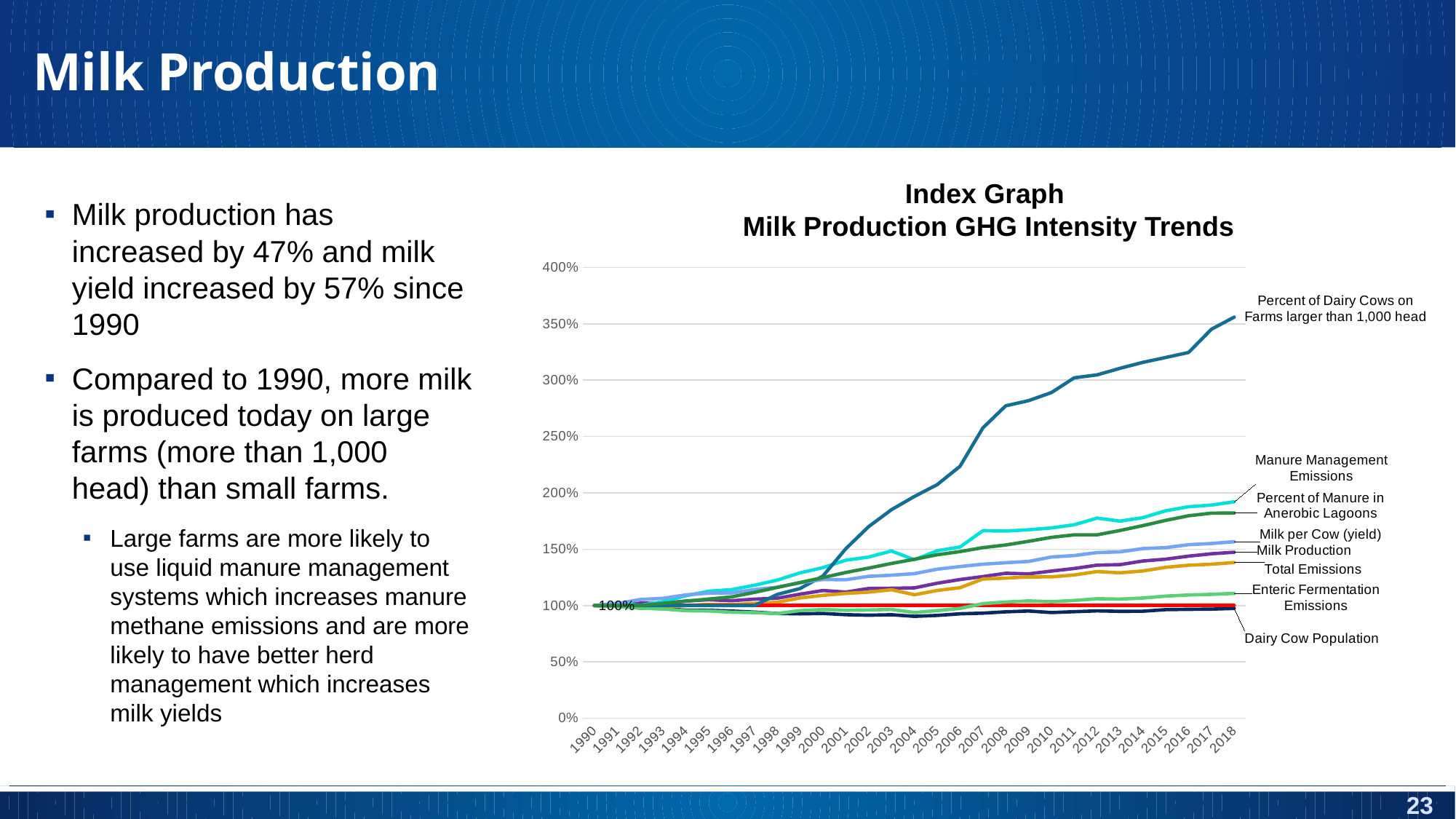
Is the value for Manure Management Emissions in 2018 greater or less than 150%? greater What value is labelled on the chart for the year 1990? 100% Does the Percent of Dairy Cows on Farms larger than 1,000 head series rise or fall from 1990 to 2018? rise In 2018, which is higher: Manure Management Emissions or Milk Production? Manure Management Emissions Is the value for Percent of Dairy Cows on Farms larger than 1,000 head in 2018 greater or less than 300%? greater How many series are labelled on the chart? 8 How many years are shown along the x axis of the chart? 29 Which series has the lowest value in 2018? Dairy Cow Population Is the value for Milk Production in 2018 greater or less than 200%? less What kind of chart is shown on the slide? line chart What is the title of the chart? Index Graph Milk Production GHG Intensity Trends Which series has the highest value in 2018? Percent of Dairy Cows on Farms larger than 1,000 head